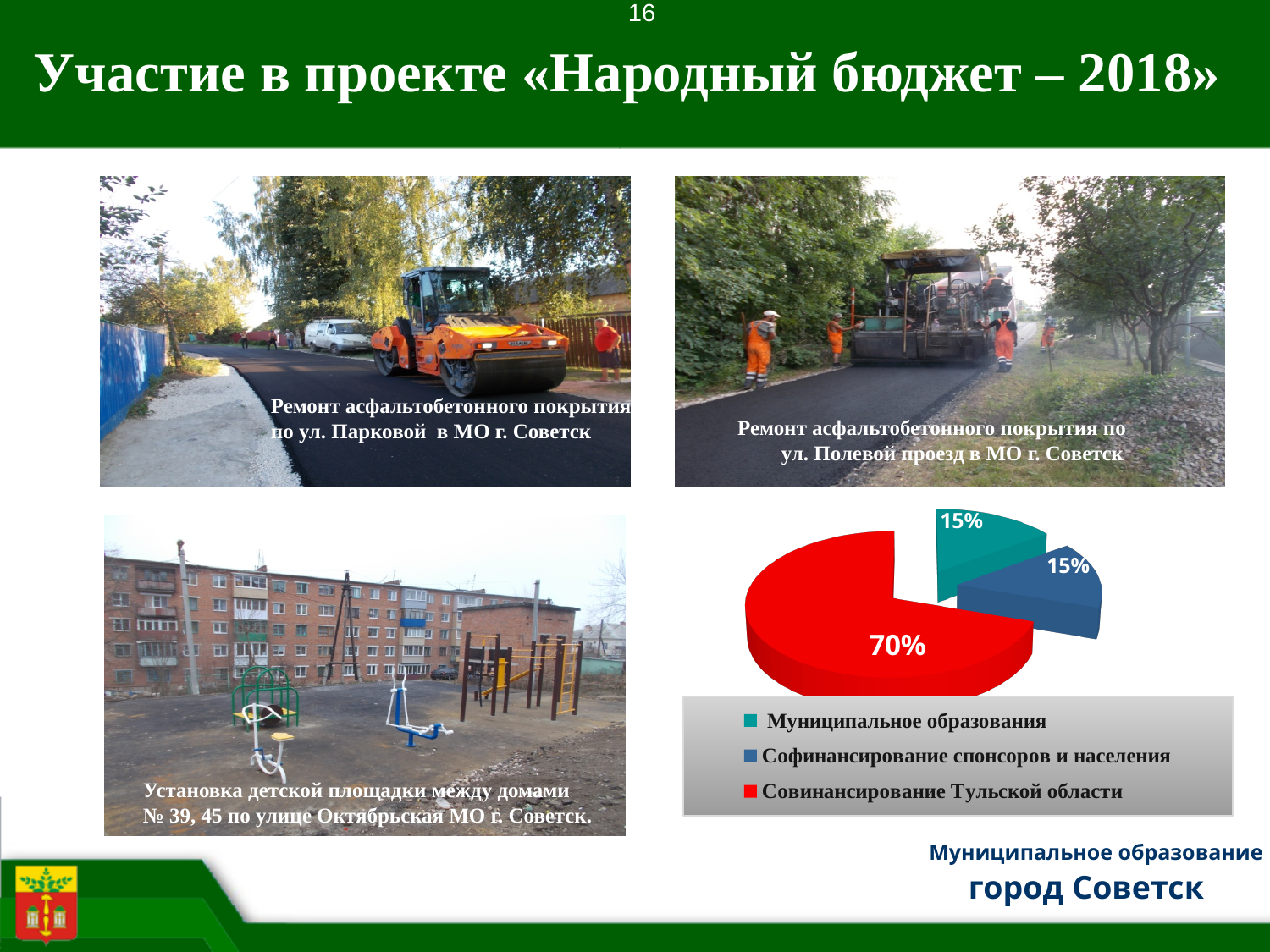
How many entries does the legend of the pie chart list? 3 How many slices does the pie chart have? 3 What is the combined share of «Муниципальное образования» and «Софинансирование спонсоров и населения» in the pie chart? 30% What share of the pie chart is labelled «Муниципальное образования»? 15% What colour is the slice for «Совинансирование Тульской области» in the pie chart? red What is the difference between the share for «Совинансирование Тульской области» and the share for «Муниципальное образования»? 55% What colour is the slice for «Муниципальное образования» in the pie chart? teal What kind of chart is shown on the slide? pie chart Which is larger in the pie chart: «Совинансирование Тульской области» or «Софинансирование спонсоров и населения»? Совинансирование Тульской области What share of the pie chart is labelled «Софинансирование спонсоров и населения»? 15% What share of the pie chart is labelled «Совинансирование Тульской области»? 70% Which category has the largest slice in the pie chart? Совинансирование Тульской области